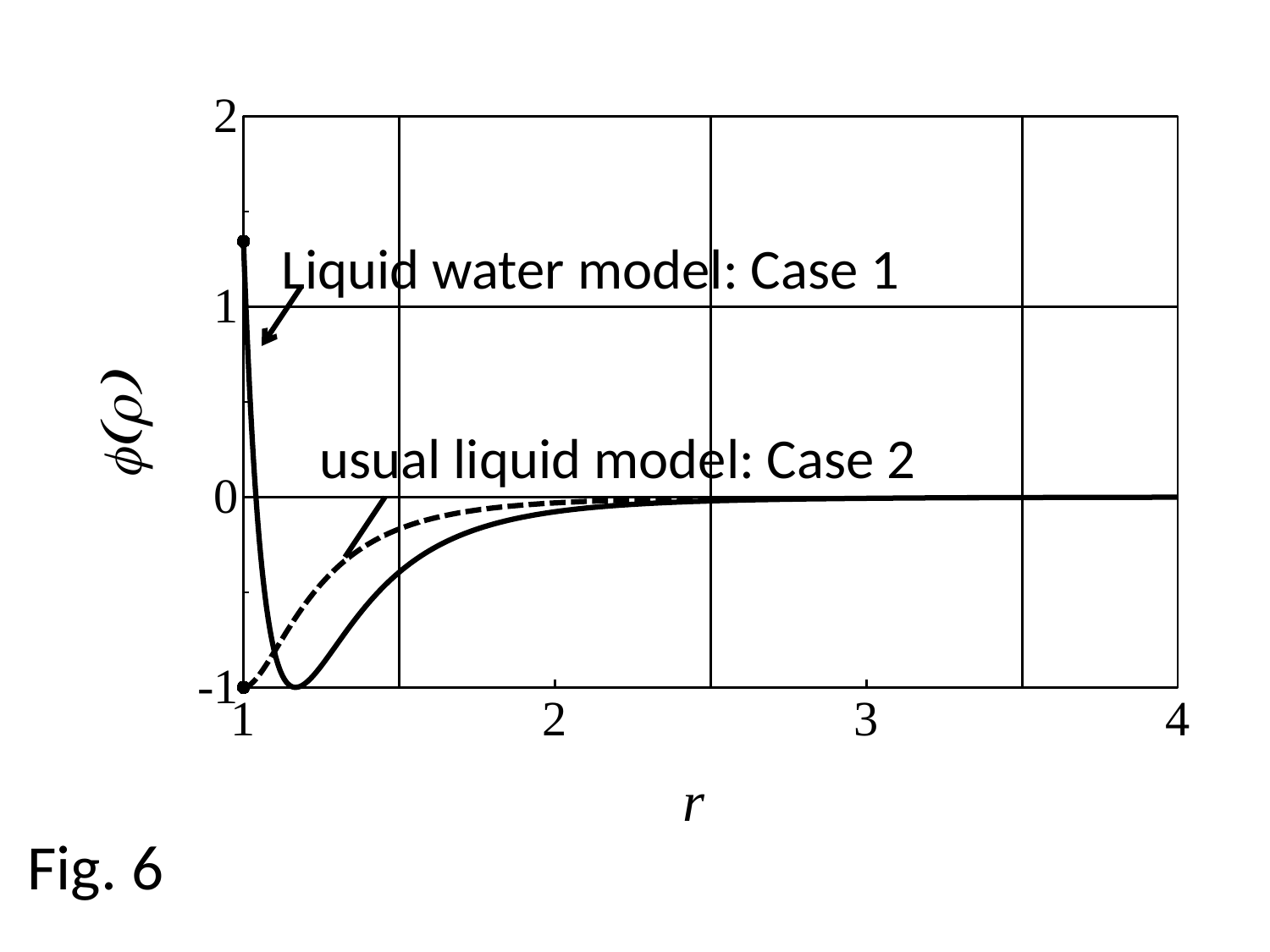
How many labeled tick values are shown on the x axis? 4 Which curve is drawn with a dashed line? usual liquid model: Case 2 How many curves (series) are plotted on the chart? 2 At r = 1, which curve has the higher value, Case 1 or Case 2? Case 1 At r = 1.5, which curve has the higher value, Case 1 or Case 2? Case 2 What kind of chart is shown on the slide? line chart What is the value of the usual liquid model (Case 2) curve at r = 1? -1 Is the value of the Liquid water model (Case 1) curve at r = 1 greater or less than 1? greater Is the value of the Liquid water model (Case 1) curve at r = 1.5 greater or less than 0? less Does the usual liquid model (Case 2) curve rise or fall as r increases from 1 to 2? rise What is the label of the x axis? r Toward what value do both curves converge as r approaches 4? 0